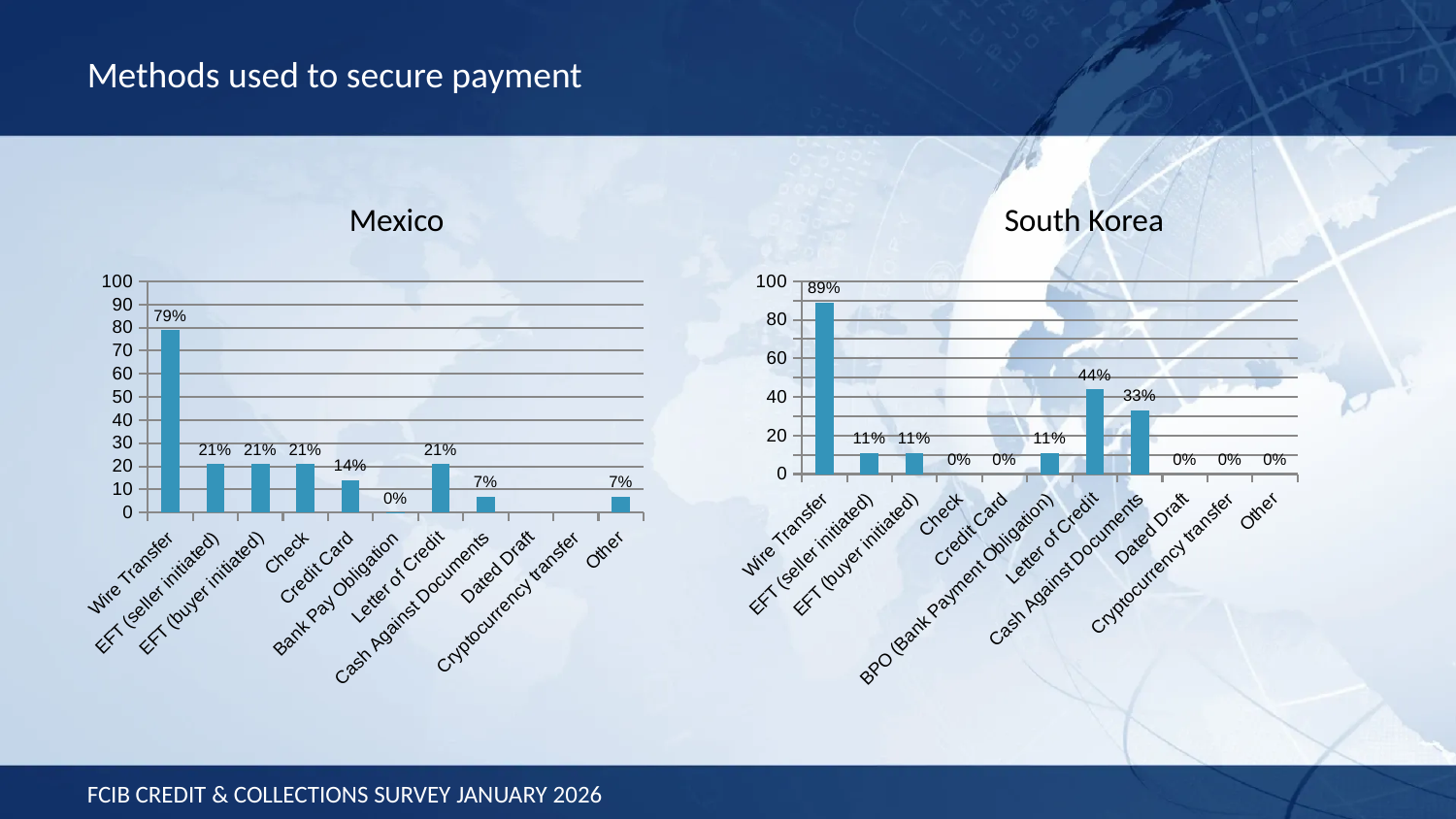
In the Mexico chart, what is the value for Wire Transfer? 79% In the Mexico chart, which category has the highest value? Wire Transfer In the South Korea chart, what is the value for Cash Against Documents? 33% In the Mexico chart, what is the difference between Wire Transfer and Check? 58% In the Mexico chart, what is the value for Credit Card? 14% In the South Korea chart, what is the difference between Wire Transfer and Letter of Credit? 45% What type of chart is the Mexico chart? Bar chart In the South Korea chart, which category has the highest value? Wire Transfer In the South Korea chart, what is the value for Letter of Credit? 44% How many categories are shown on the x axis of the South Korea chart? 11 In the South Korea chart, is the value for Letter of Credit greater or less than 40? greater Which is larger: Wire Transfer in the Mexico chart or Wire Transfer in the South Korea chart? South Korea